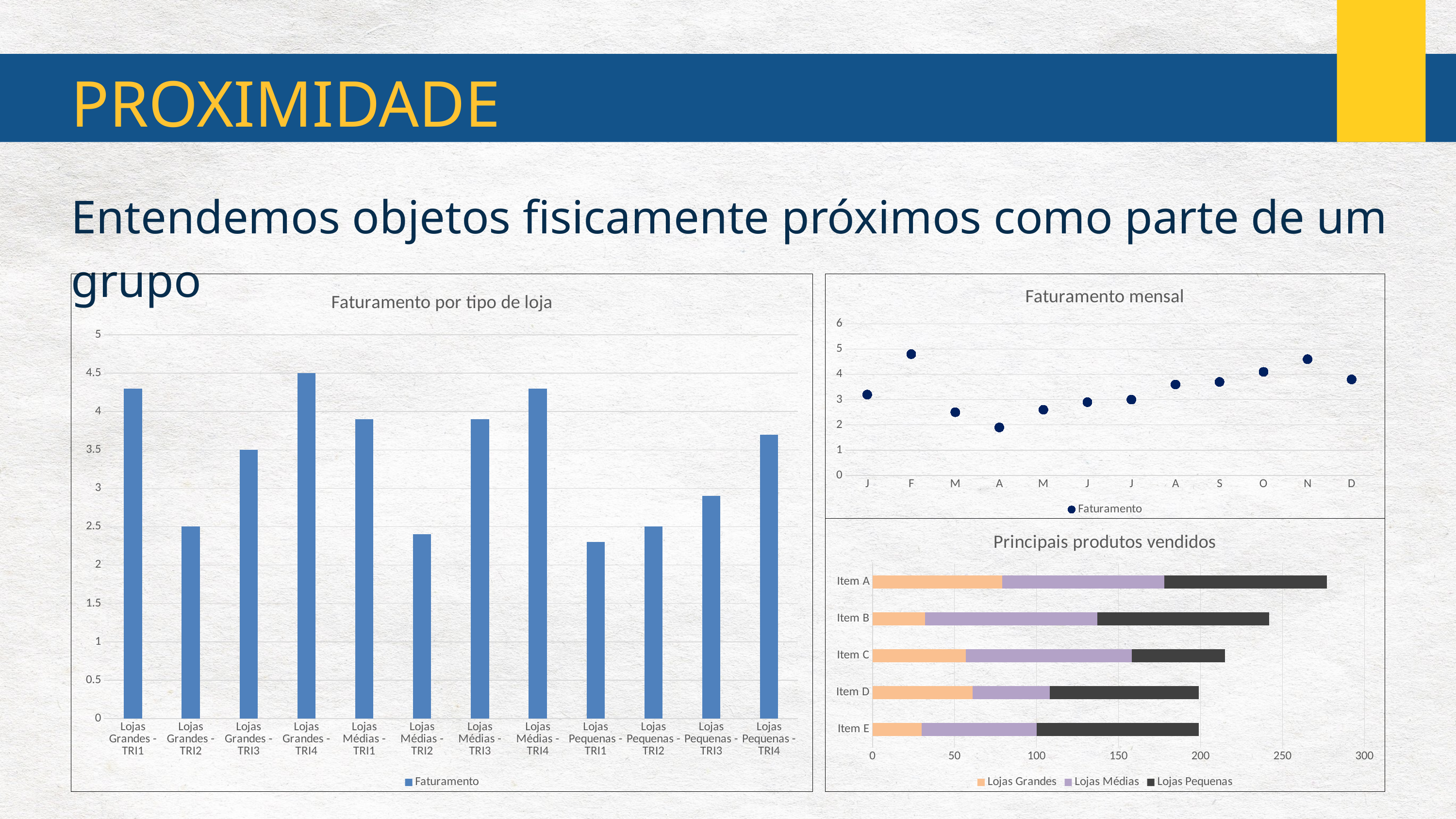
In 'Faturamento mensal', which month has the lowest value? A In 'Faturamento por tipo de loja', which is larger, Lojas Médias - TRI1 or Lojas Médias - TRI2? Lojas Médias - TRI1 In 'Faturamento por tipo de loja', which category has the highest value? Lojas Grandes - TRI4 How many series does the legend of 'Principais produtos vendidos' list? 3 In 'Faturamento mensal', do the values rise or fall from A to N? rise What kind of chart is 'Faturamento por tipo de loja'? bar chart In 'Faturamento mensal', how many data points are plotted? 12 In 'Faturamento por tipo de loja', is the value for Lojas Pequenas - TRI1 greater or less than 2.5? less In 'Principais produtos vendidos', is the total for Item A greater or less than 250? greater In 'Faturamento por tipo de loja', how many categories are shown on the x axis? 12 In 'Faturamento por tipo de loja', is the value for Lojas Grandes - TRI1 greater or less than 4? greater